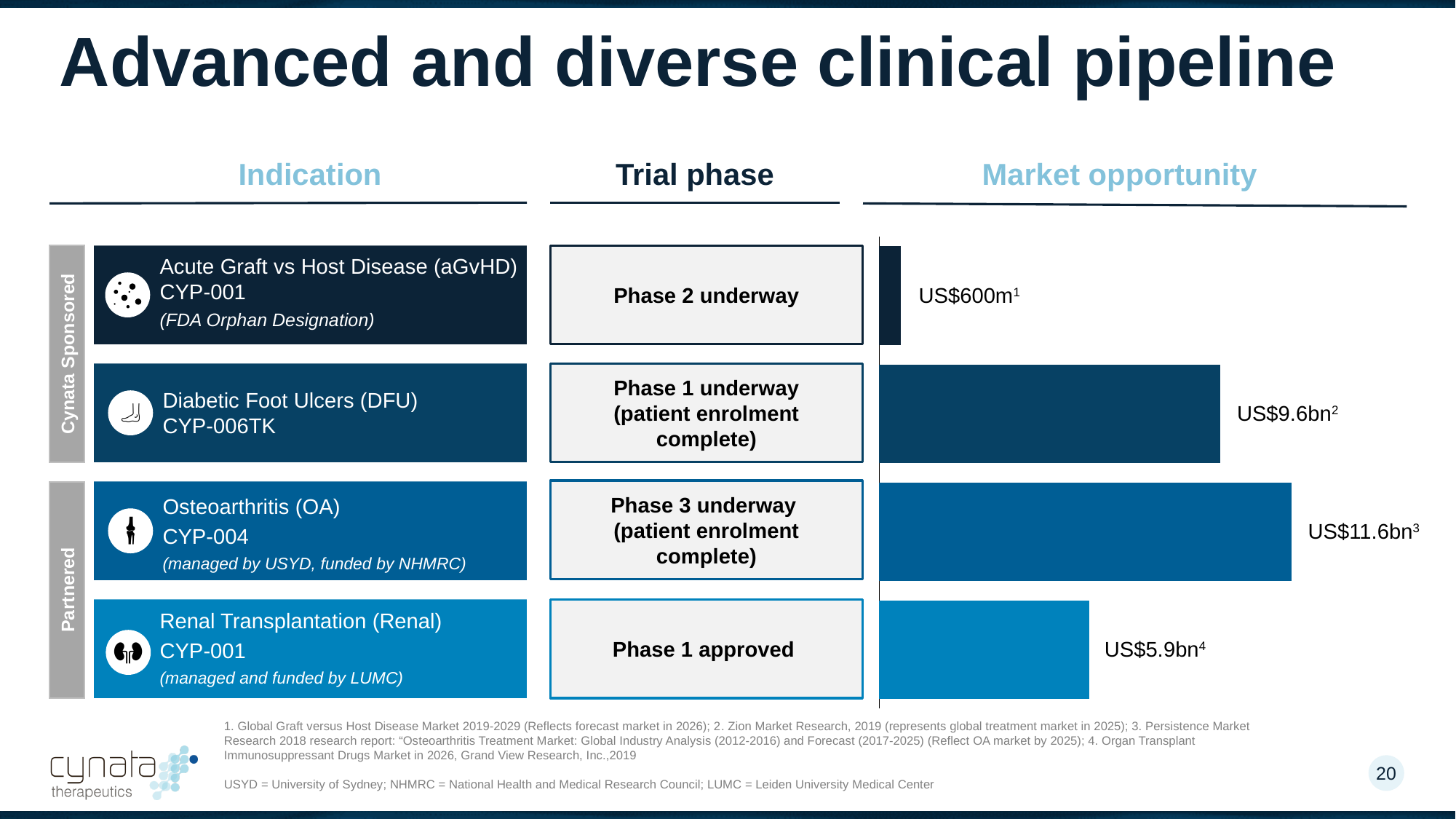
What is the market opportunity shown for Renal Transplantation (Renal)? US$5.9bn Which indication has the largest market opportunity bar? Osteoarthritis (OA) What is the market opportunity shown for Osteoarthritis (OA)? US$11.6bn What is the difference between the market opportunity for Osteoarthritis (OA) and Diabetic Foot Ulcers (DFU)? US$2.0bn What is the difference between the market opportunity for Diabetic Foot Ulcers (DFU) and Renal Transplantation (Renal)? US$3.7bn What is the column heading above the market opportunity bars? Market opportunity What kind of chart is used to show the market opportunity? Bar chart How many indications have market opportunity bars on the slide? 4 What is the market opportunity shown for Diabetic Foot Ulcers (DFU)? US$9.6bn Which has the larger market opportunity, Diabetic Foot Ulcers (DFU) or Renal Transplantation (Renal)? Diabetic Foot Ulcers (DFU) What is the market opportunity shown for Acute Graft vs Host Disease (aGvHD)? US$600m Which indication has the smallest market opportunity bar? Acute Graft vs Host Disease (aGvHD)